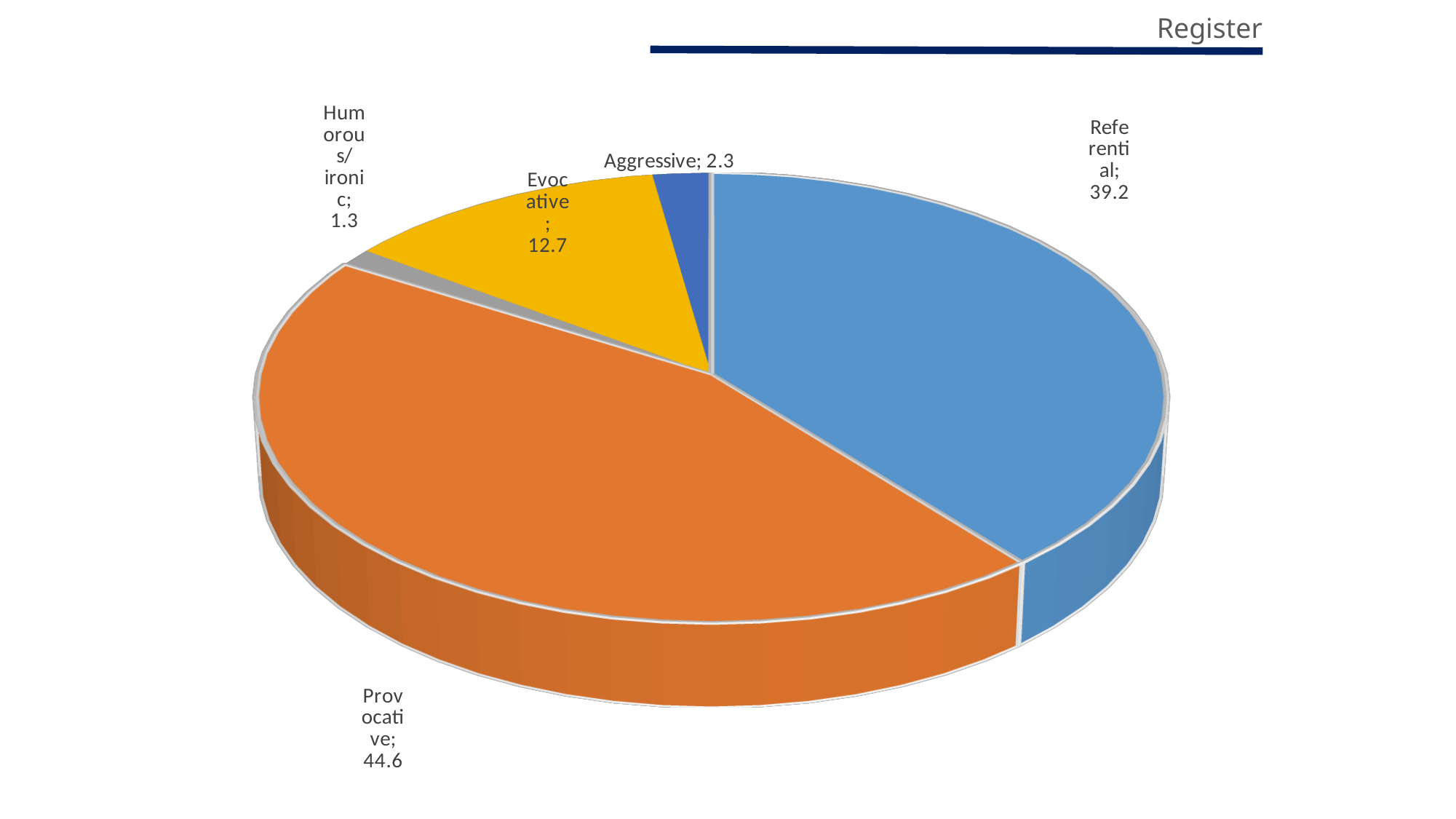
What is the value for the Referential slice? 39.2 Which is larger, the Evocative value or the Aggressive value? Evocative How many slices does the pie chart have? 5 Which category has the largest slice of the pie? Provocative What is the value for the Evocative slice? 12.7 Which category has the smallest slice of the pie? Humorous/ironic What is the title of the chart? Register What is the value for the Humorous/ironic slice? 1.3 What is the value for the Aggressive slice? 2.3 What type of chart is shown on the slide? pie chart What is the value for the Provocative slice? 44.6 What is the difference between the Provocative and Referential values? 5.4